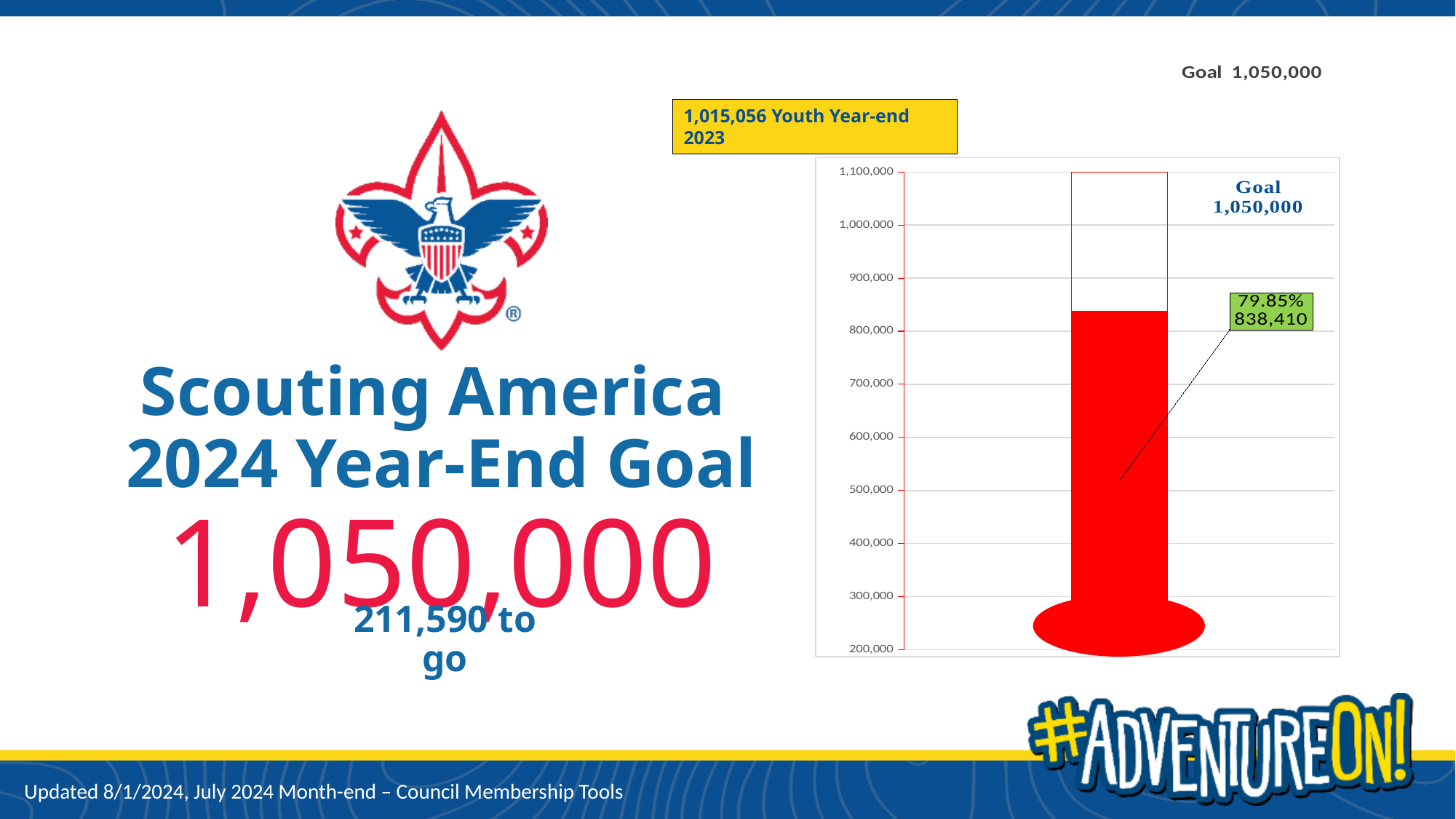
What is the highest value shown on the chart's vertical axis? 1,100,000 Is the filled value on the thermometer chart greater or less than 800,000? greater What value does the data label on the thermometer chart show for the current membership? 838,410 How far below the goal of 1,050,000 is the current value of 838,410? 211,590 Is the filled value on the thermometer chart greater or less than 900,000? less What goal value is printed on the chart? 1,050,000 What is the lowest value shown on the chart's vertical axis? 200,000 What percentage of the goal does the chart's data label show has been reached? 79.85% Which is larger, the current value shown on the chart or the goal? the goal What kind of chart is shown on the slide? bar chart